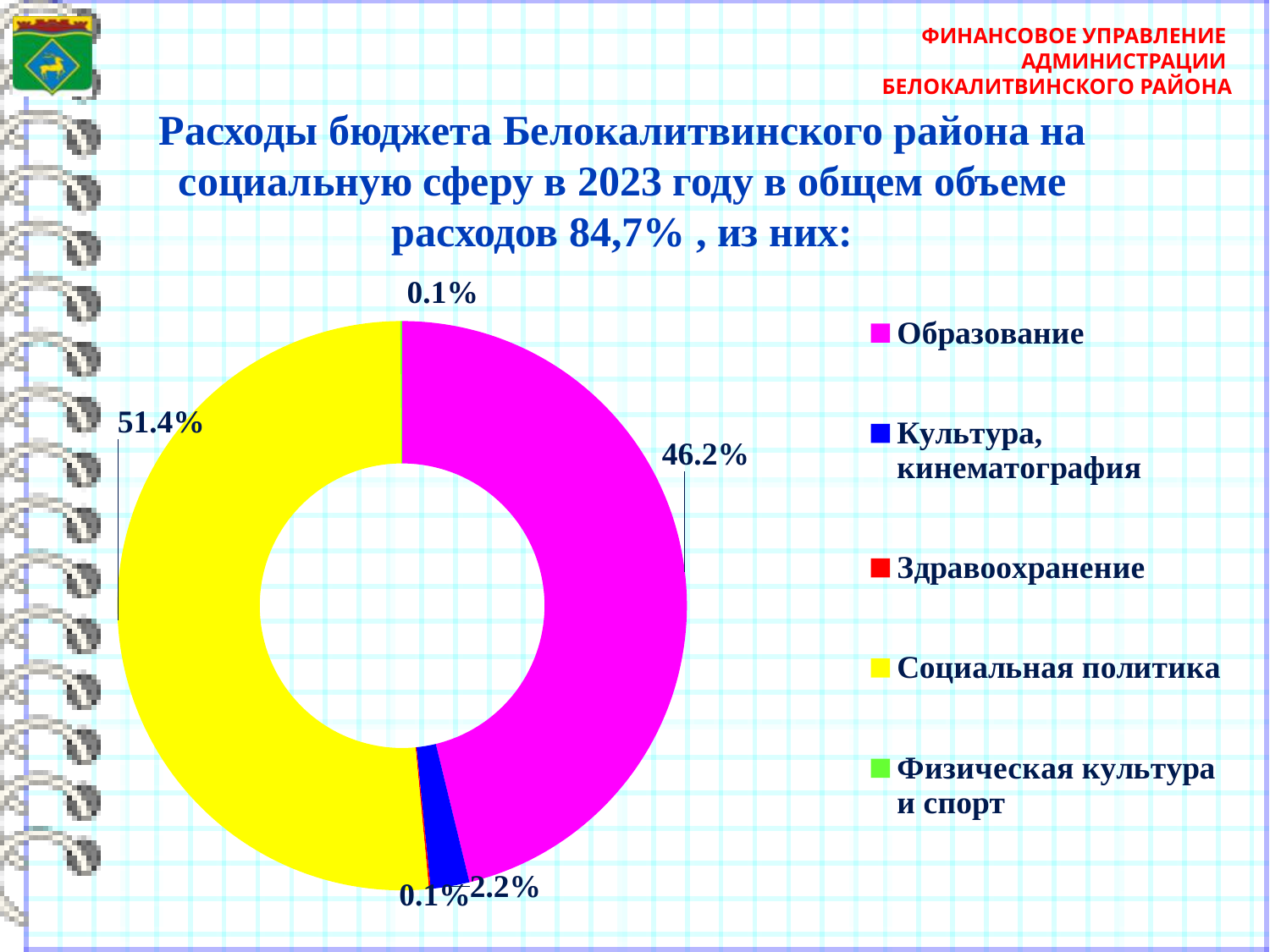
What share of the chart does Образование account for? 46.2% What is the value shown for Культура, кинематография? 2.2% Which category has the largest share of the chart? Социальная политика How many categories does the legend list? 5 What is the difference between the shares of Социальная политика and Образование? 5.2% What is the value shown for Физическая культура и спорт? 0.1% What colour represents Социальная политика in the chart? Yellow What is the value shown for Здравоохранение? 0.1% What colour represents Образование in the chart? Magenta (pink) What kind of chart is shown on the slide? Doughnut (pie) chart What is the value shown for Социальная политика? 51.4% Which is larger, Образование or Социальная политика? Социальная политика